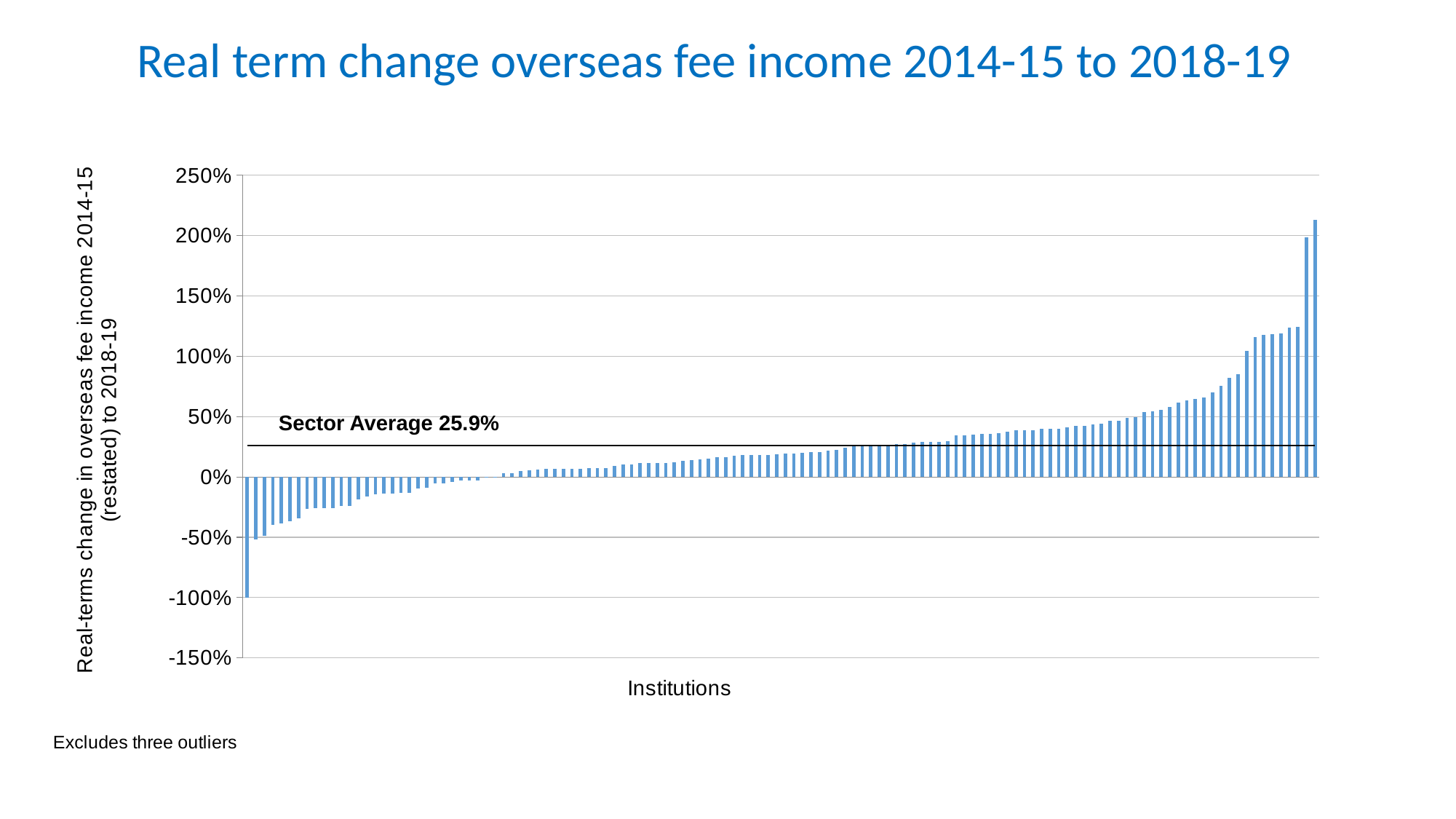
What is the label on the x axis of the chart? Institutions Is the value for the tallest (rightmost) bar greater or less than 200%? greater Which is larger, the value of the leftmost bar or the value of the rightmost bar? the rightmost bar Do the bar values rise or fall moving from left to right along the x axis? rise What is the title of the chart? Real term change overseas fee income 2014-15 to 2018-19 Is the value for the leftmost bar greater or less than 0%? less What kind of chart is shown on the slide? bar chart Is the value for the leftmost bar greater or less than -50%? less What is the sector average value marked by the horizontal line on the chart? 25.9%